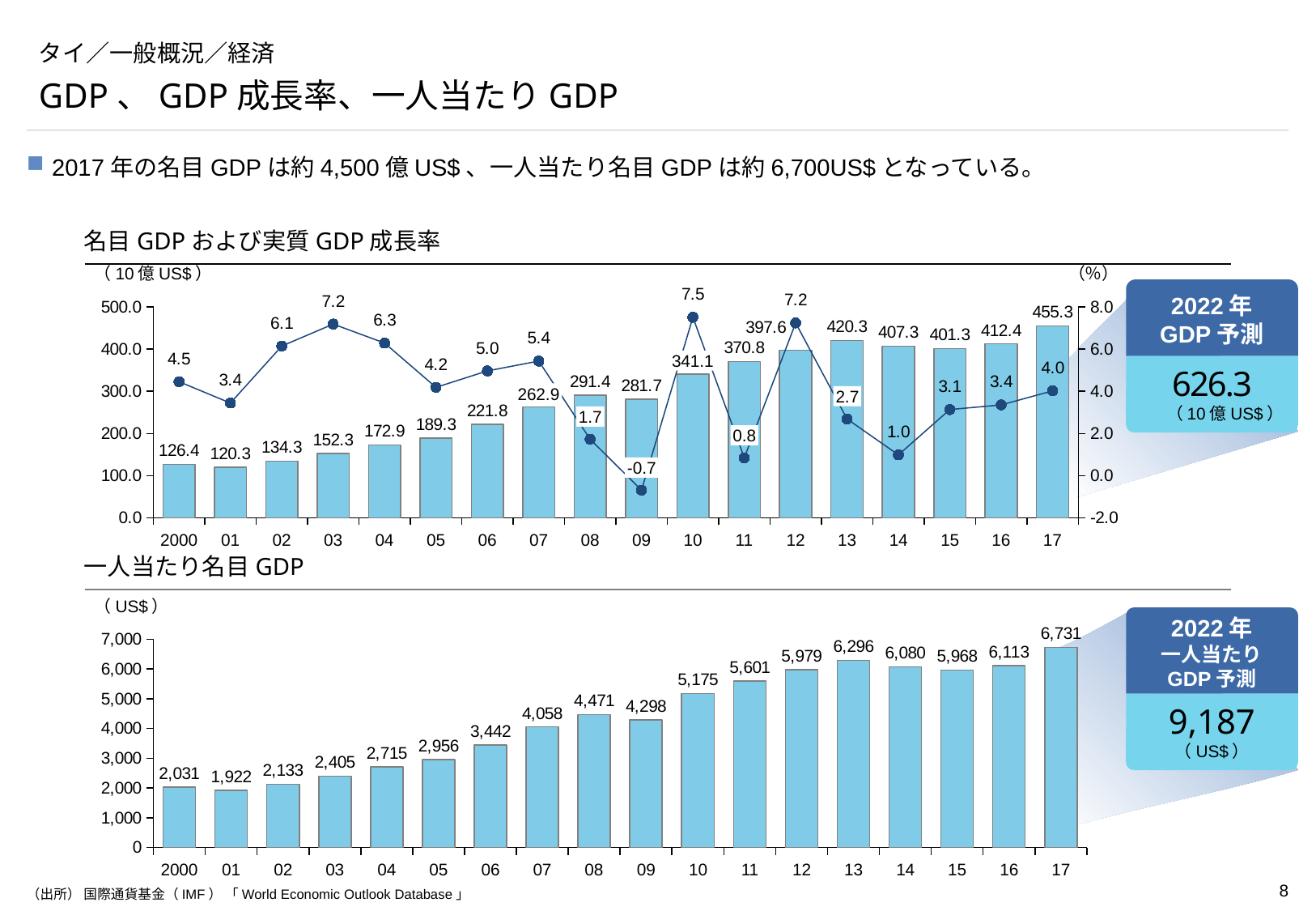
In the bottom chart (一人当たり名目GDP), which year has the larger value, 14 or 15? 14 In the top chart (名目GDPおよび実質GDP成長率), what is the nominal GDP bar value for 2010? 341.1 In the bottom chart (一人当たり名目GDP), what is the difference between the values for 17 and 16? 618 In the top chart (名目GDPおよび実質GDP成長率), which year has the highest real GDP growth rate? 10 In the top chart (名目GDPおよび実質GDP成長率), which year has the lowest nominal GDP bar? 01 In the top chart (名目GDPおよび実質GDP成長率), how many years are plotted on the x axis? 18 What is the 2022 per-capita GDP forecast (2022年一人当たりGDP予測) shown next to the bottom chart? 9,187 In the top chart (名目GDPおよび実質GDP成長率), by how much did nominal GDP increase from 16 to 17? 42.9 In the bottom chart (一人当たり名目GDP), which year has the highest value? 17 In the bottom chart (一人当たり名目GDP), what is the value for 2013? 6,296 In the top chart (名目GDPおよび実質GDP成長率), what is the real GDP growth rate shown for 2009? -0.7 What kind of chart is the bottom chart (一人当たり名目GDP)? bar chart